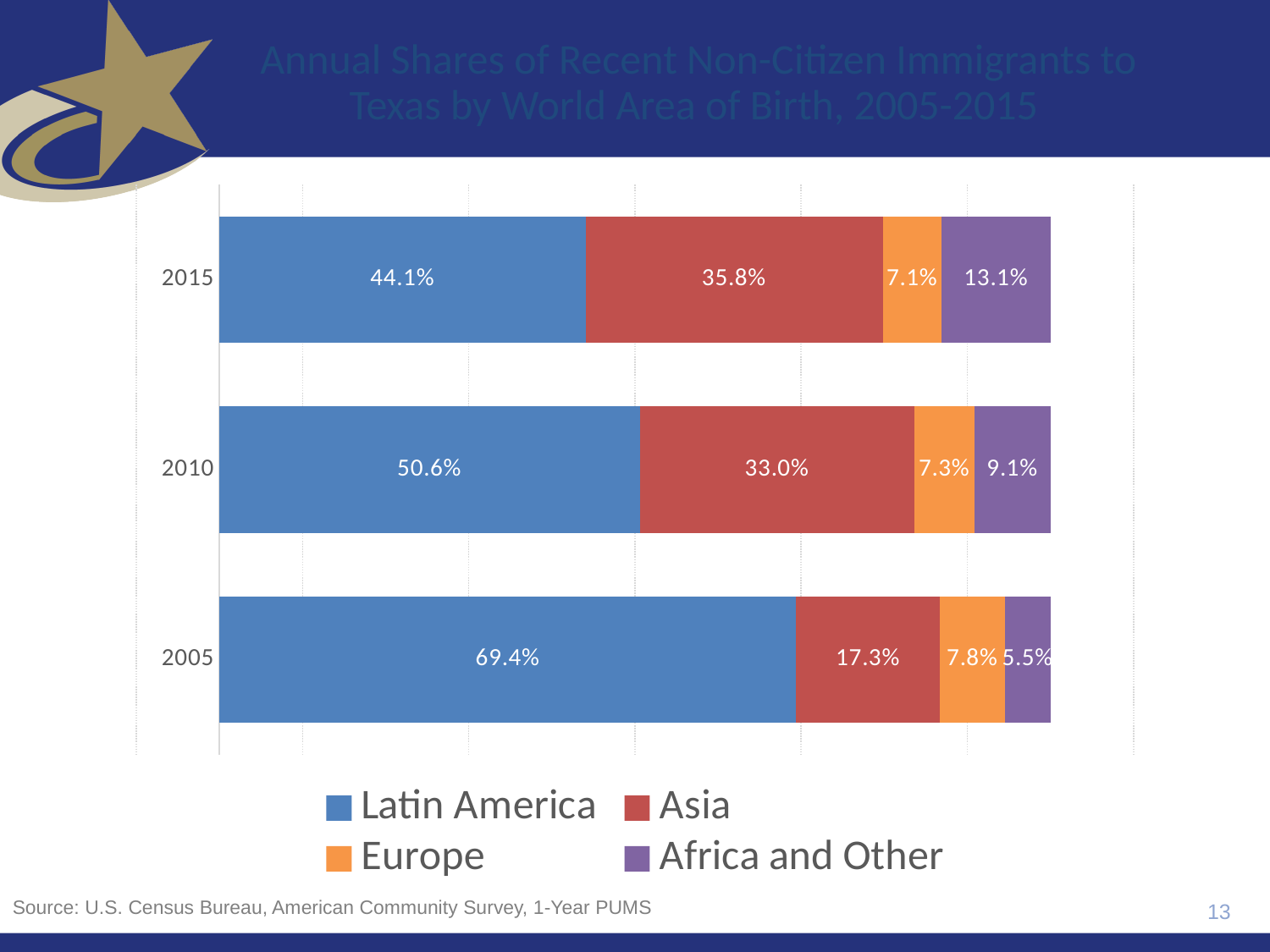
What is the value for Africa and Other in 2015? 13.1% How many years are shown on the chart? 3 How many series does the legend list? 4 What is the value for Europe in 2005? 7.8% What kind of chart is shown on the slide? Stacked bar chart What is the value for Asia in 2010? 33.0% By how many percentage points did the Latin America share fall from 2005 to 2015? 25.3 percentage points In which year was the Latin America share the highest? 2005 In which year was the Asia share the lowest? 2005 Does the Latin America share rise or fall from 2005 to 2015? Fall Which year had the larger Asia share, 2010 or 2015? 2015 What share of recent non-citizen immigrants in 2015 was from Latin America? 44.1%